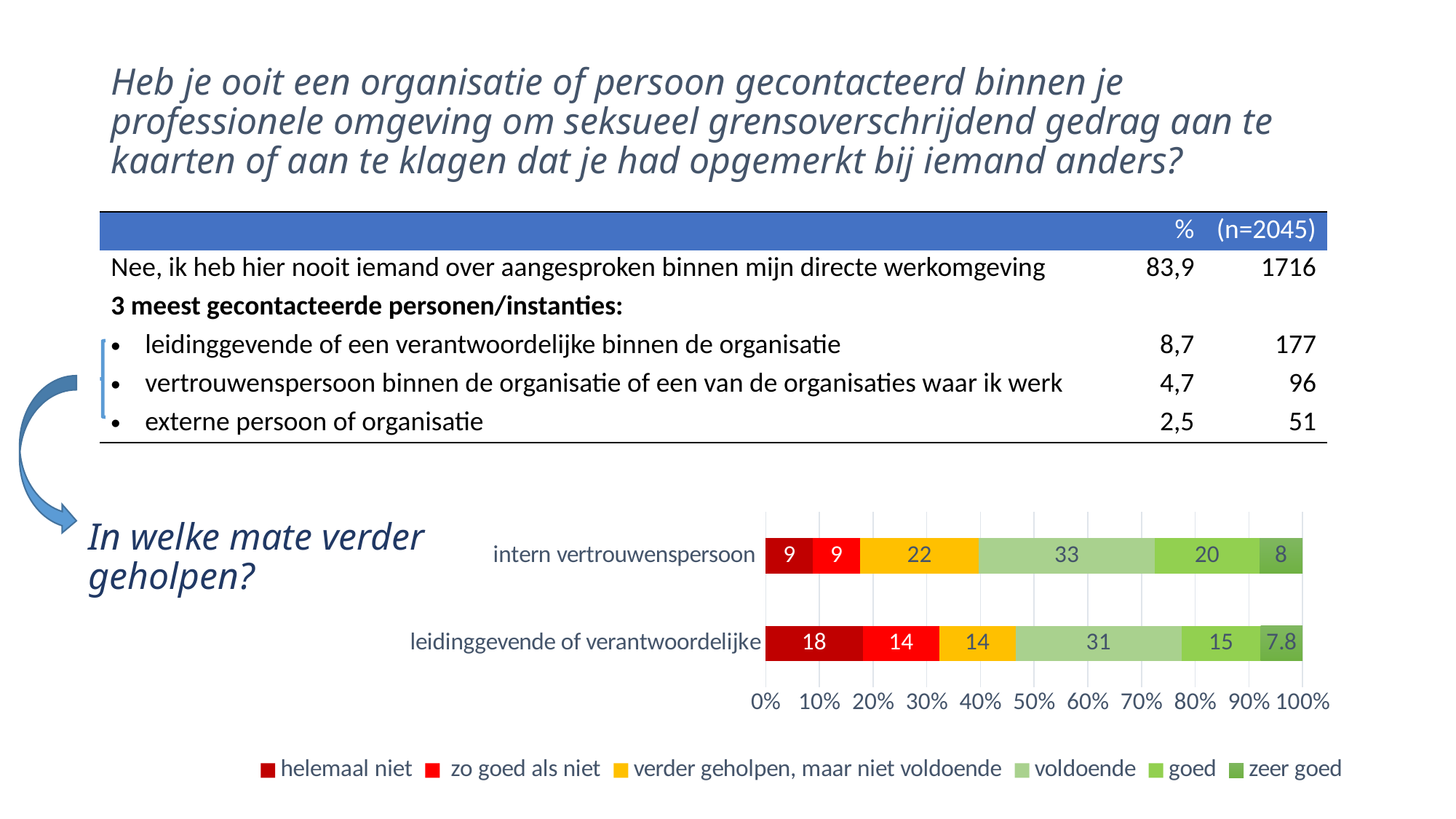
Which series has the largest segment in the 'intern vertrouwenspersoon' bar? voldoende How many categories are plotted in the chart? 2 What is the value of 'verder geholpen, maar niet voldoende' for 'intern vertrouwenspersoon'? 22 What is the value of 'voldoende' for 'intern vertrouwenspersoon'? 33 What colour is used for the 'helemaal niet' series in the chart? dark red What is the difference between the 'goed' values for 'intern vertrouwenspersoon' and 'leidinggevende of verantwoordelijke'? 5 What is the value of 'helemaal niet' for 'leidinggevende of verantwoordelijke'? 18 How many series does the chart legend list? 6 Which category has the higher value for 'helemaal niet'? leidinggevende of verantwoordelijke Which series has the smallest segment in the 'leidinggevende of verantwoordelijke' bar? zeer goed What is the value of 'zeer goed' for 'leidinggevende of verantwoordelijke'? 7.8 What kind of chart is shown on the slide? stacked bar chart